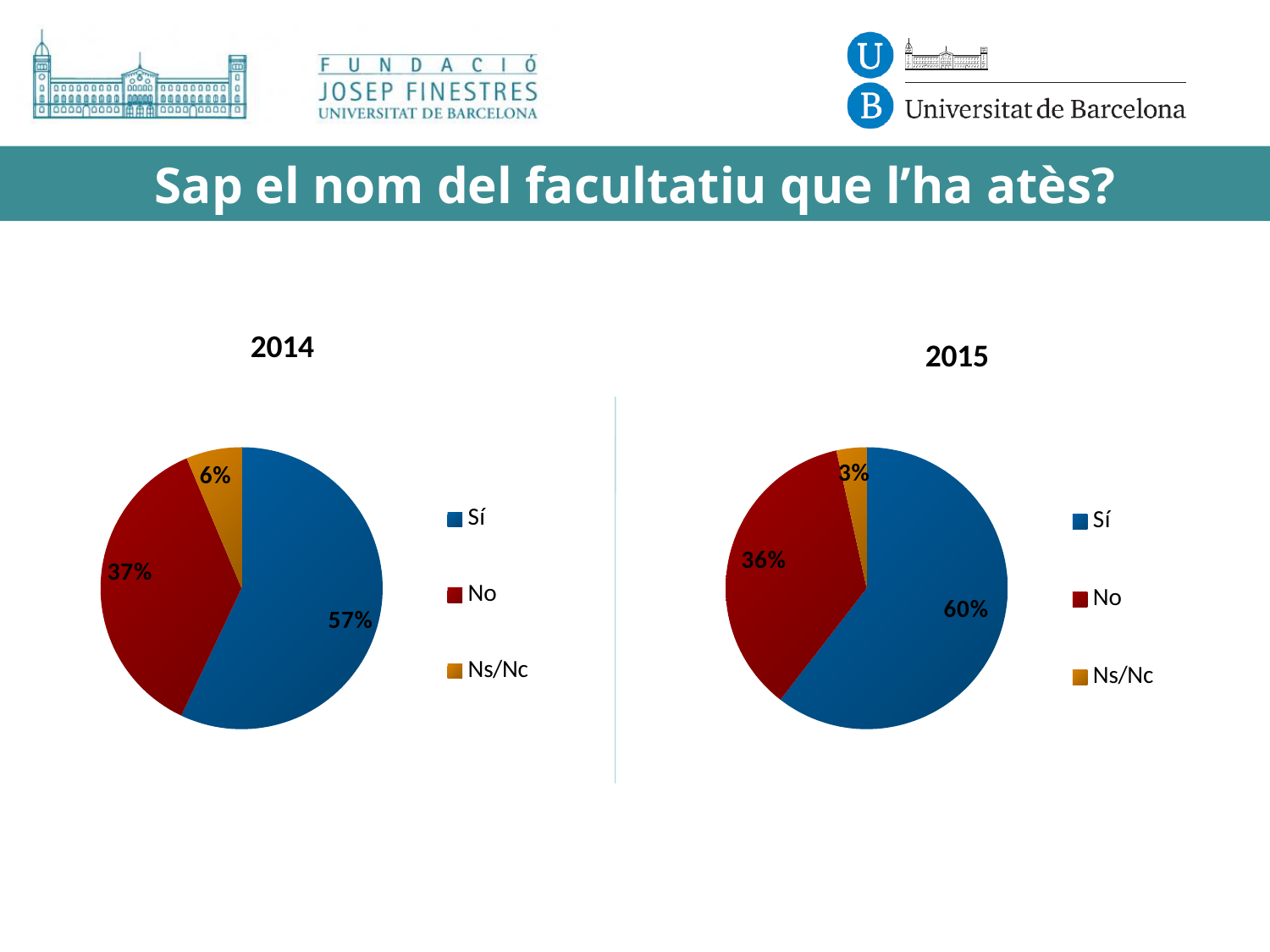
In the 2015 chart, what is the value for Ns/Nc? 3% What type of chart is the 2015 chart? Pie chart In the 2014 chart, what percentage of respondents answered Sí? 57% Is the Sí share larger in the 2014 chart or the 2015 chart? 2015 In the 2015 chart, which category has the largest slice? Sí In the 2014 chart, what percentage of respondents answered No? 37% How many categories does the 2014 chart show? 3 In the 2014 chart, what is the value for Ns/Nc? 6% In the 2015 chart, what percentage of respondents answered Sí? 60% In the 2014 chart, which category has the smallest slice? Ns/Nc What colour represents the No category in the 2014 chart? Red In the 2015 chart, what is the difference between the Sí and No percentages? 24%